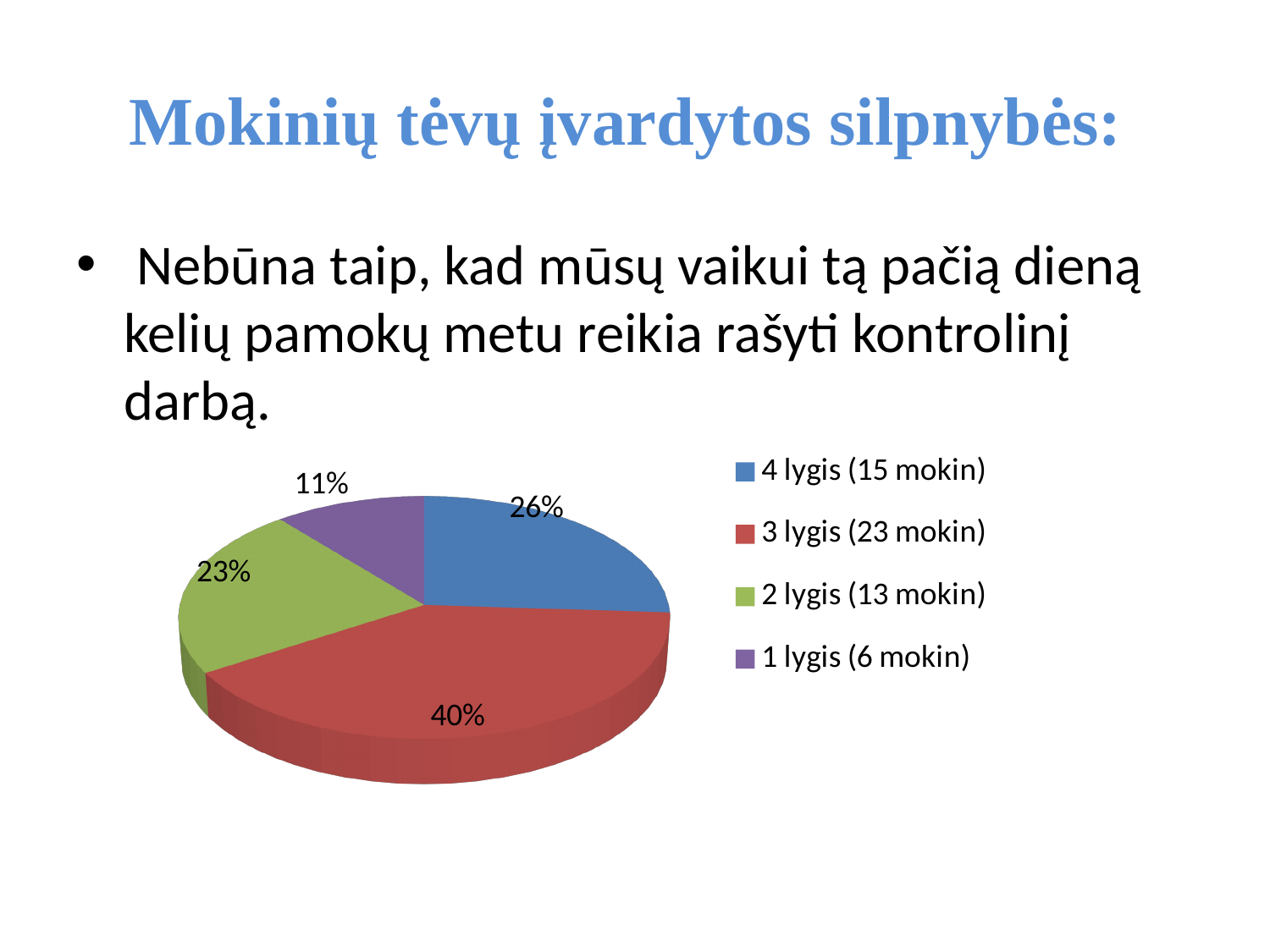
What share of the pie does "4 lygis (15 mokin)" have? 26% What share of the pie does "1 lygis (6 mokin)" have? 11% How many slices does the pie chart have? 4 Which category has the largest slice of the pie? 3 lygis (23 mokin) What share of the pie does "2 lygis (13 mokin)" have? 23% How many entries does the legend list? 4 What colour is the slice for "2 lygis (13 mokin)"? green What is the difference in percentage points between the "3 lygis (23 mokin)" slice and the "4 lygis (15 mokin)" slice? 14% Which category has the smallest slice of the pie? 1 lygis (6 mokin) What kind of chart is shown on the slide? pie chart Which slice is larger: "4 lygis (15 mokin)" or "2 lygis (13 mokin)"? 4 lygis (15 mokin)